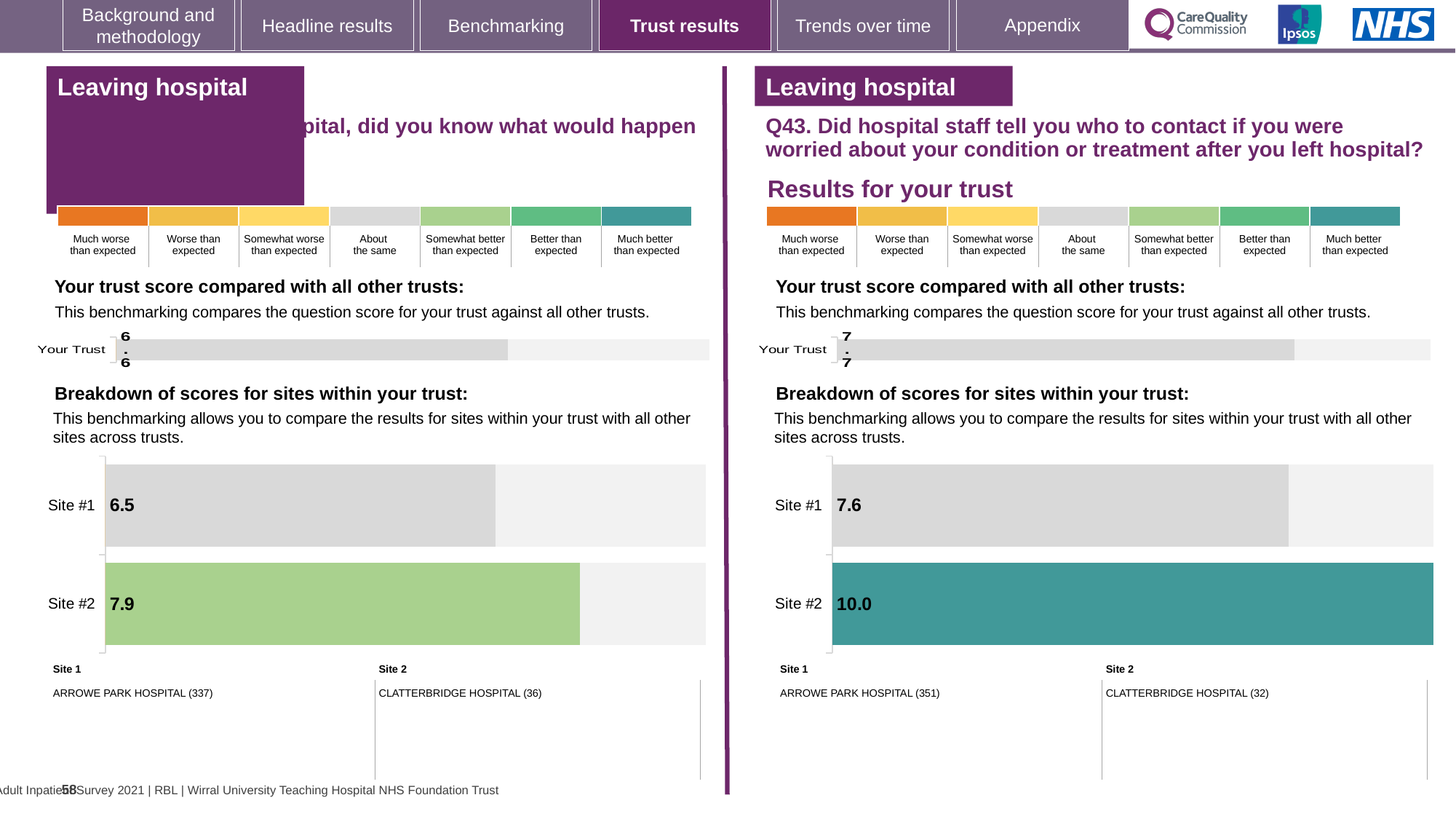
What type of chart is used for the site breakdown on the right-hand side for Q43? Bar chart How many sites are shown in the right-hand site breakdown chart for Q43? 2 On the left-hand 'Your trust score compared with all other trusts' chart, what is the score shown for Your Trust? 6.6 On the left-hand site breakdown chart, which site has the lower score? Site #1 On the left-hand site breakdown chart, what is the score for Site #2? 7.9 On the right-hand 'Your trust score compared with all other trusts' chart for Q43, what is the score shown for Your Trust? 7.7 On the right-hand chart for Q43, what is the score for Site #1? 7.6 On the left-hand site breakdown chart, what is the score for Site #1? 6.5 On the right-hand chart for Q43, which site has the higher score? Site #2 On the left-hand site breakdown chart, what is the difference between the Site #2 and Site #1 scores? 1.4 On the right-hand chart for Q43, what is the score for Site #2? 10.0 On the right-hand chart for Q43, what is the difference between the Site #2 and Site #1 scores? 2.4